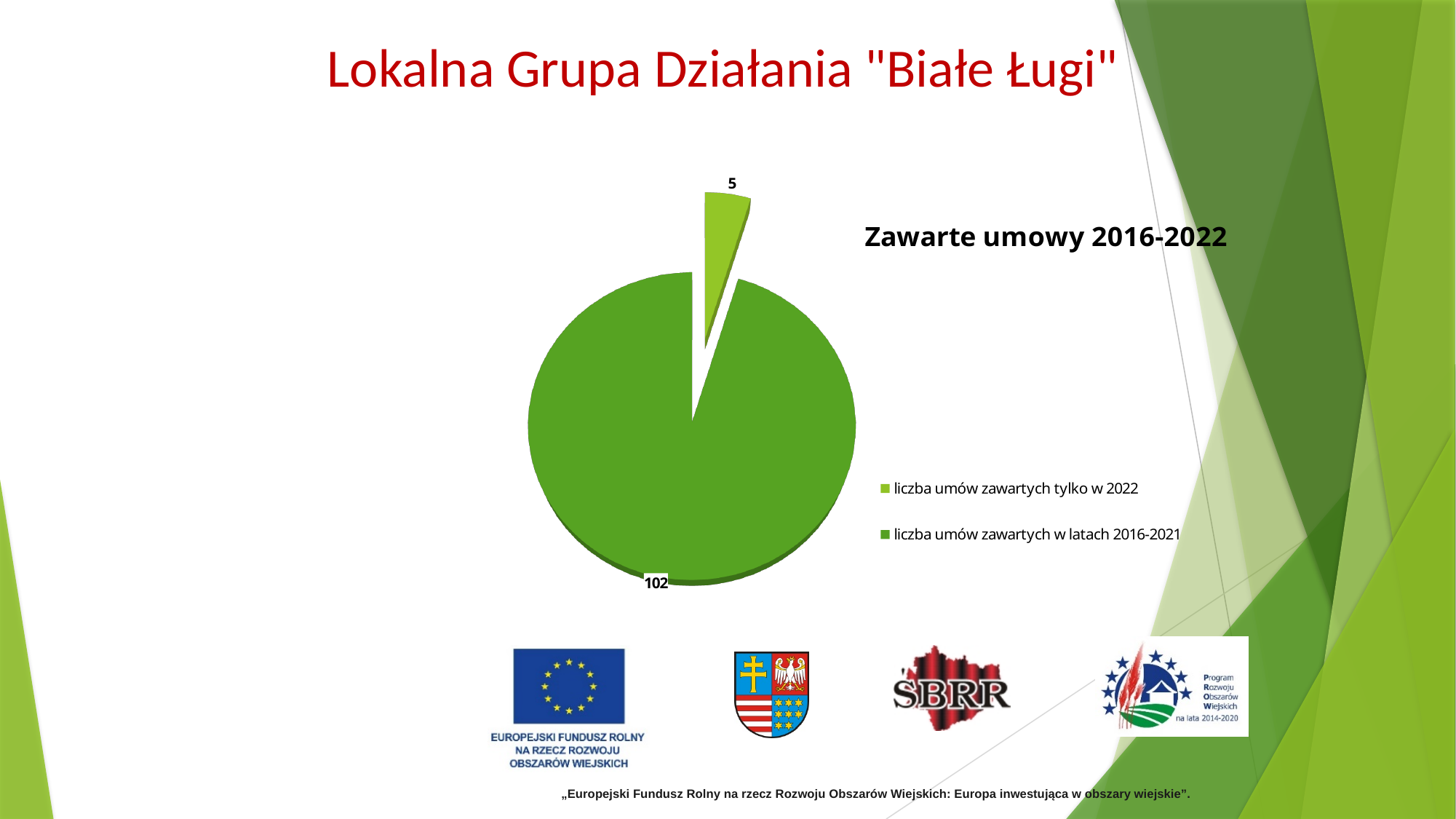
How many slices does the pie chart have? 2 What kind of chart is shown on the slide? pie chart Which slice is the largest? liczba umów zawartych w latach 2016-2021 What is the title of the chart? Zawarte umowy 2016-2022 What is the difference between the number of contracts concluded in 2016-2021 and those concluded only in 2022? 97 What is the value for 'liczba umów zawartych tylko w 2022'? 5 How many entries does the legend list? 2 What is the total of the two slices in the pie chart? 107 What is the value for 'liczba umów zawartych w latach 2016-2021'? 102 What fraction of the total contracts does the 'liczba umów zawartych tylko w 2022' slice represent? 5 out of 107 Which is larger: the number of contracts concluded only in 2022 or the number concluded in 2016-2021? liczba umów zawartych w latach 2016-2021 Which slice is the smallest? liczba umów zawartych tylko w 2022